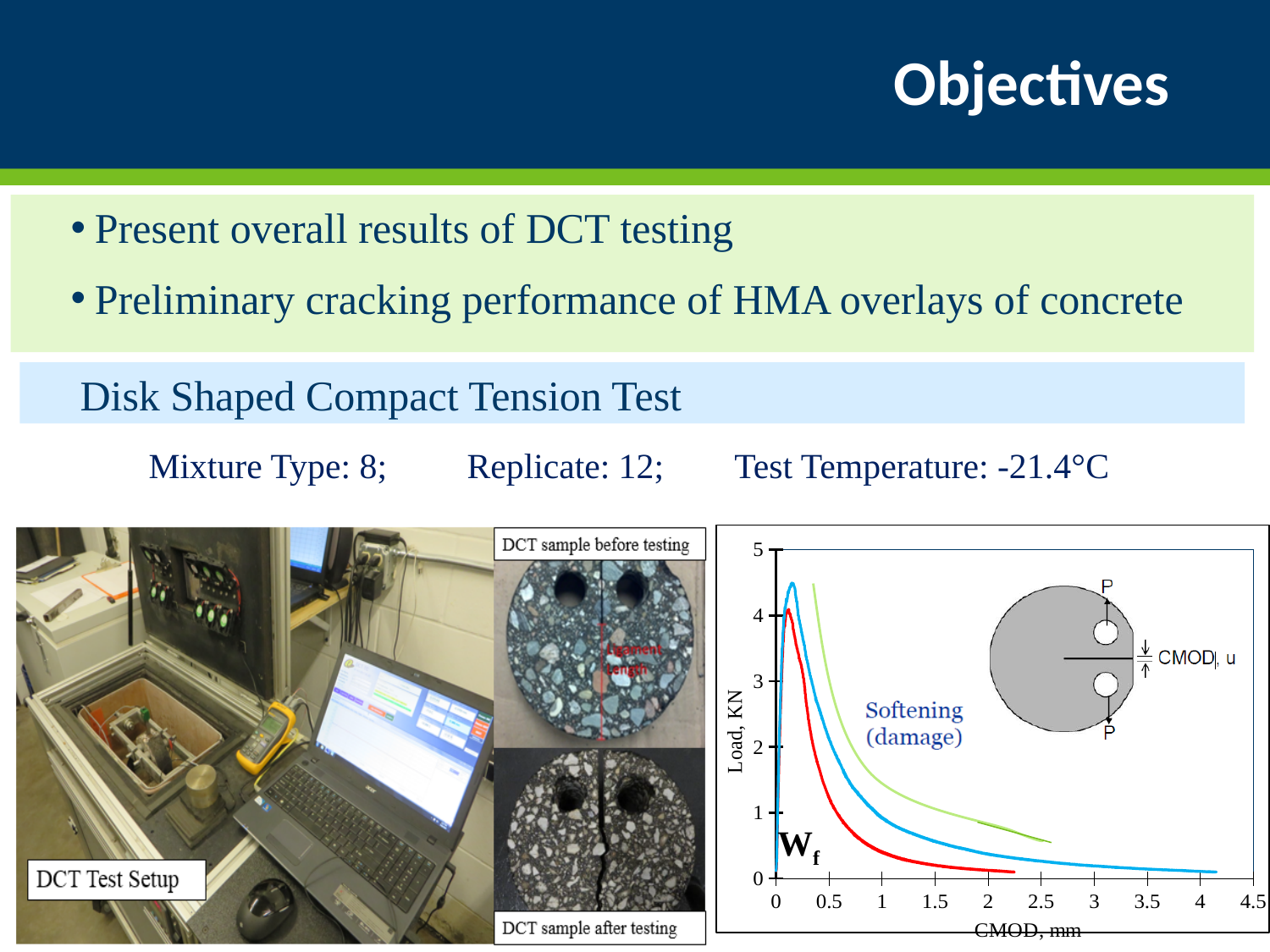
On the Load vs CMOD chart, which curve extends to the largest CMOD value: red, blue or green? blue On the Load vs CMOD chart, which curve ends at the smallest CMOD value: red, blue or green? red On the Load vs CMOD chart, is the load of the green curve at CMOD 1 mm greater or less than 1 KN? greater On the Load vs CMOD chart, after reaching its peak, does the load rise or fall as CMOD increases? fall What is the label of the x axis of the Load vs CMOD chart? CMOD, mm How many curves are plotted on the Load vs CMOD chart? 3 What kind of chart is shown at the bottom right of the slide? line chart What is the highest tick value shown on the x axis of the Load vs CMOD chart? 4.5 What is the label of the y axis of the Load vs CMOD chart? Load, KN On the Load vs CMOD chart, is the peak load of the red curve greater or less than 5 KN? less On the Load vs CMOD chart, is the load of the red curve at CMOD 1 mm greater or less than 2 KN? less